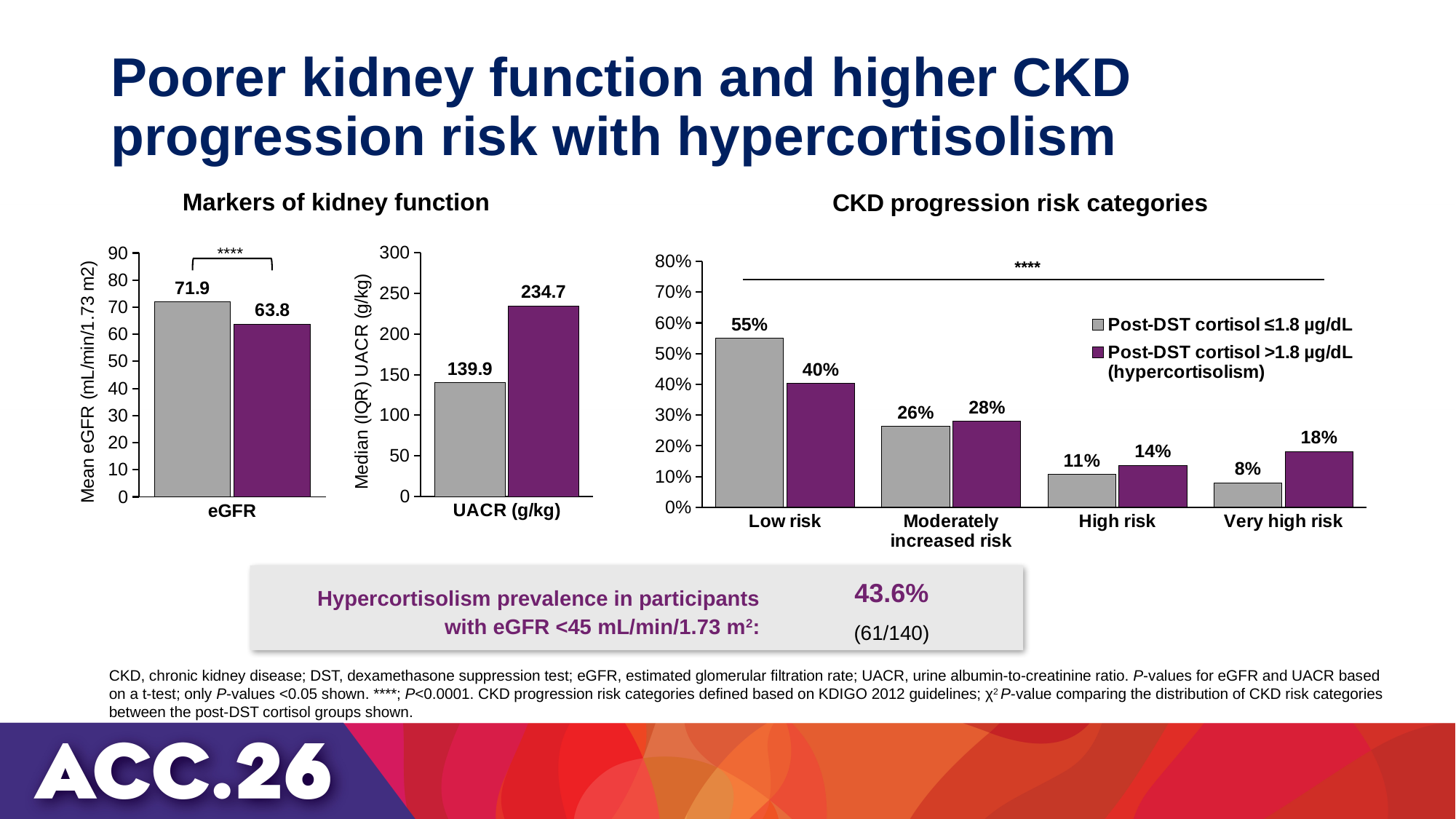
How many series does the legend of the CKD progression risk categories chart list? 2 In the CKD progression risk categories chart, what percentage of the Post-DST cortisol ≤1.8 µg/dL group is in the Low risk category? 55% In the CKD progression risk categories chart, which risk category has the lowest value for the Post-DST cortisol ≤1.8 µg/dL group? Very high risk In the eGFR chart, what is the mean eGFR for the hypercortisolism group (purple bar)? 63.8 In the UACR chart, what is the median UACR for the hypercortisolism group (purple bar)? 234.7 How many risk categories are shown on the x axis of the CKD progression risk categories chart? 4 In the eGFR chart, what is the difference in mean eGFR between the gray bar and the purple bar? 8.1 In the eGFR chart, what is the mean eGFR for the Post-DST cortisol ≤1.8 µg/dL group (gray bar)? 71.9 In the UACR chart, what is the difference between the two median UACR values? 94.8 In the CKD progression risk categories chart, what is the difference between the two groups in the High risk category? 3% In the CKD progression risk categories chart, what percentage of the hypercortisolism group is in the Very high risk category? 18% In the UACR chart, which group has the higher median UACR, the gray bar or the purple bar? Purple bar (Post-DST cortisol >1.8 µg/dL, hypercortisolism)